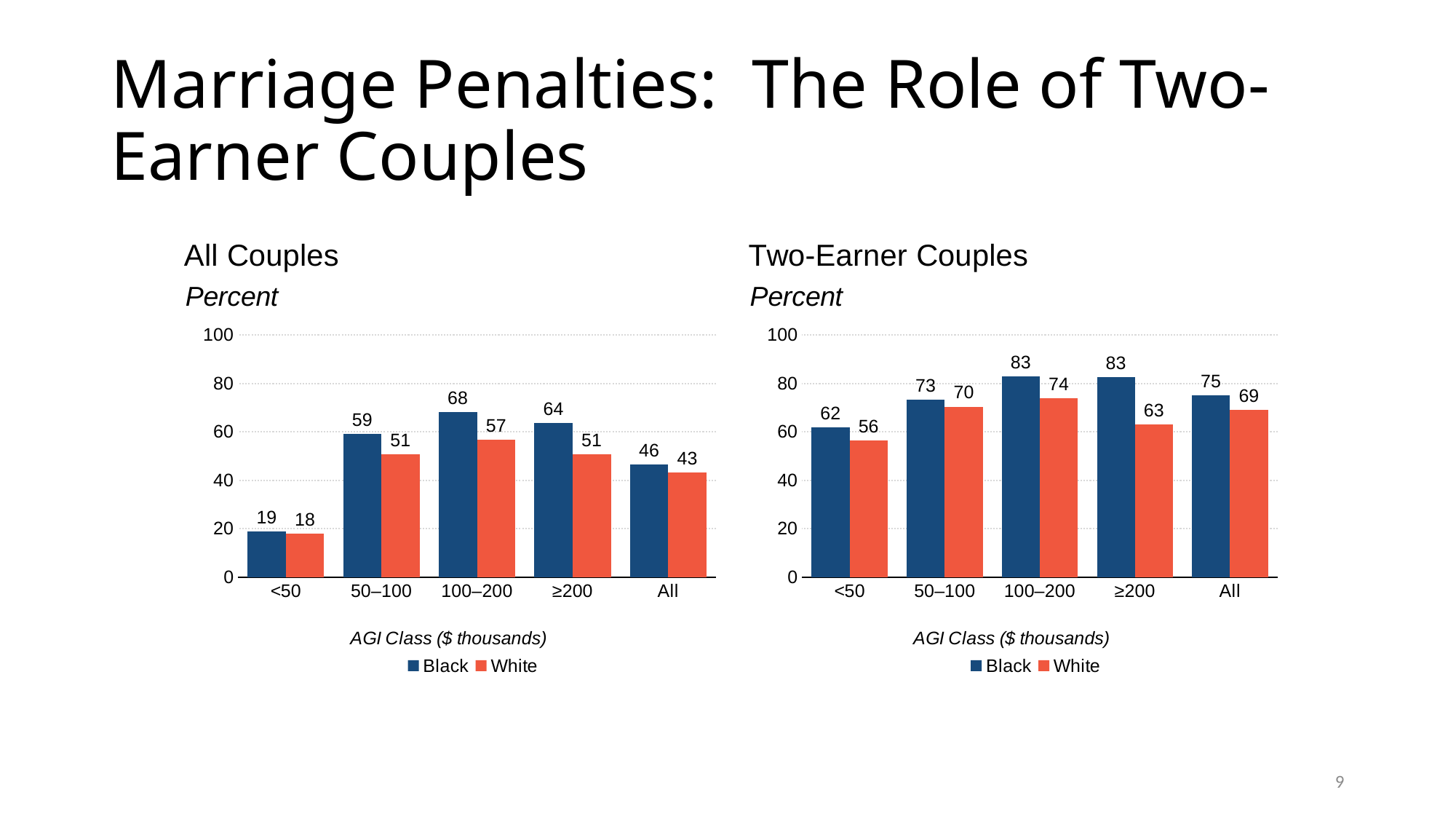
In the Two-Earner Couples chart, what is the difference between the Black and White values for the ≥200 AGI class? 20 In the All Couples chart, is the value for White in the 100–200 AGI class greater or less than 60? less In the All Couples chart, what is the difference between the Black and White values for the 50–100 AGI class? 8 In the All Couples chart, which AGI class has the lowest value for White? <50 How many AGI class categories are shown on the x axis of the All Couples chart? 5 What kind of chart is the Two-Earner Couples chart? Bar chart In the Two-Earner Couples chart, which is larger for the All category: Black or White? Black What is the x-axis label of the All Couples chart? AGI Class ($ thousands) In the All Couples chart, what is the value for Black in the 100–200 AGI class? 68 How many series does the legend of the Two-Earner Couples chart list? 2 In the Two-Earner Couples chart, what is the value for White in the ≥200 AGI class? 63 In the Two-Earner Couples chart, which AGI class has the highest value for White? 100–200